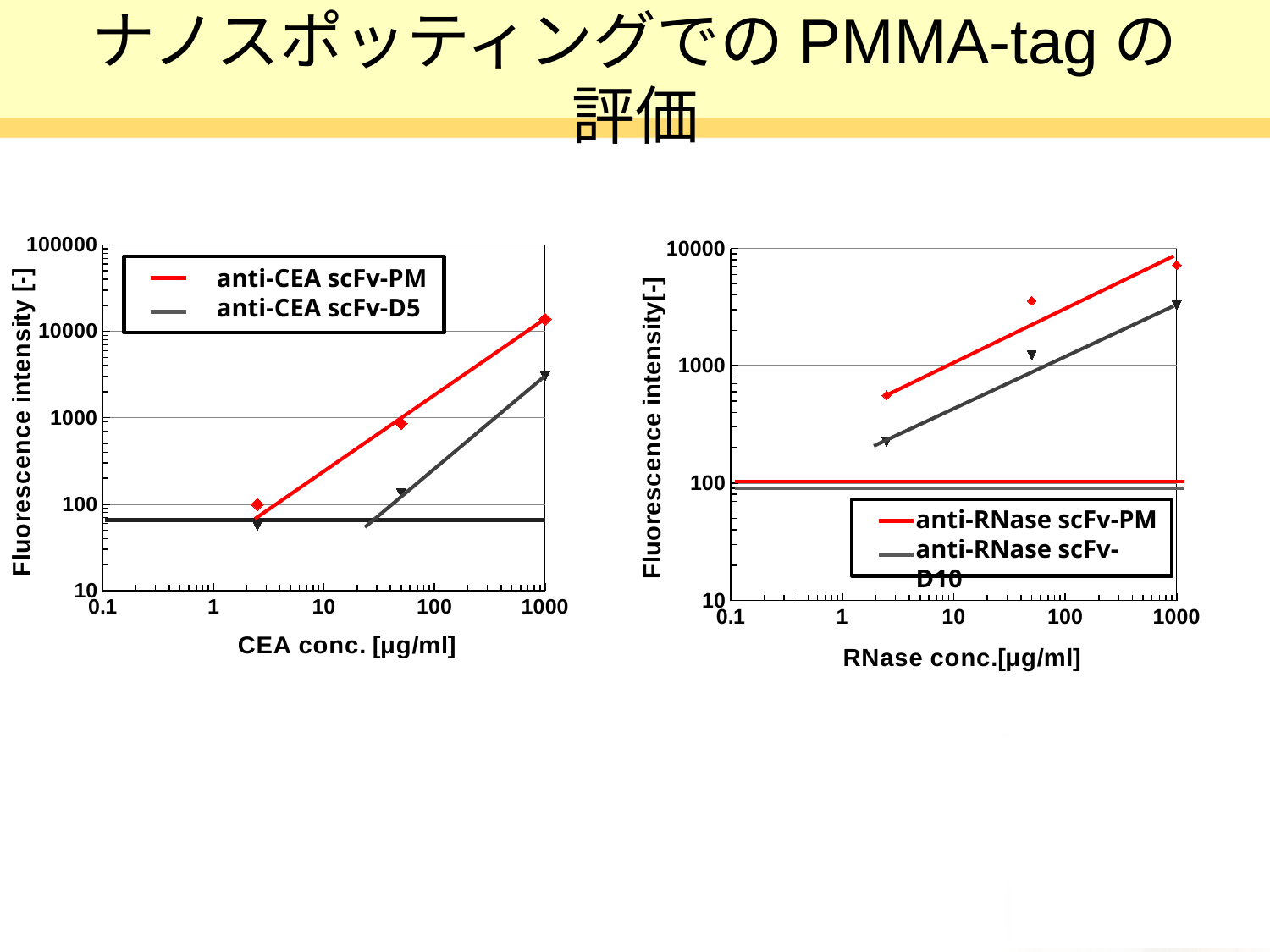
In the right chart (RNase conc.), is the fluorescence intensity for anti-RNase scFv-PM at 1000 µg/ml greater or less than 10000? less In the right chart (RNase conc.), is the fluorescence intensity for anti-RNase scFv-PM at 50 µg/ml greater or less than 1000? greater In the left chart (CEA conc.), which series has the higher fluorescence intensity at 1000 µg/ml, anti-CEA scFv-PM or anti-CEA scFv-D5? anti-CEA scFv-PM In the left chart (CEA conc.), is the fluorescence intensity for anti-CEA scFv-PM at 1000 µg/ml greater or less than 10000? greater In the right chart (RNase conc.), which series has the higher fluorescence intensity at 1000 µg/ml, anti-RNase scFv-PM or anti-RNase scFv-D10? anti-RNase scFv-PM In the right chart (RNase conc.), what are the two series named in the legend? anti-RNase scFv-PM and anti-RNase scFv-D10 In the left chart (CEA conc.), how many data points are plotted for the anti-CEA scFv-PM series? 3 In the left chart (CEA conc.), how many series does the legend list? 2 In the right chart (RNase conc.), does the fluorescence intensity for anti-RNase scFv-D10 rise or fall as RNase concentration increases? rise What kind of chart is the left chart (CEA conc.)? scatter chart with trend lines